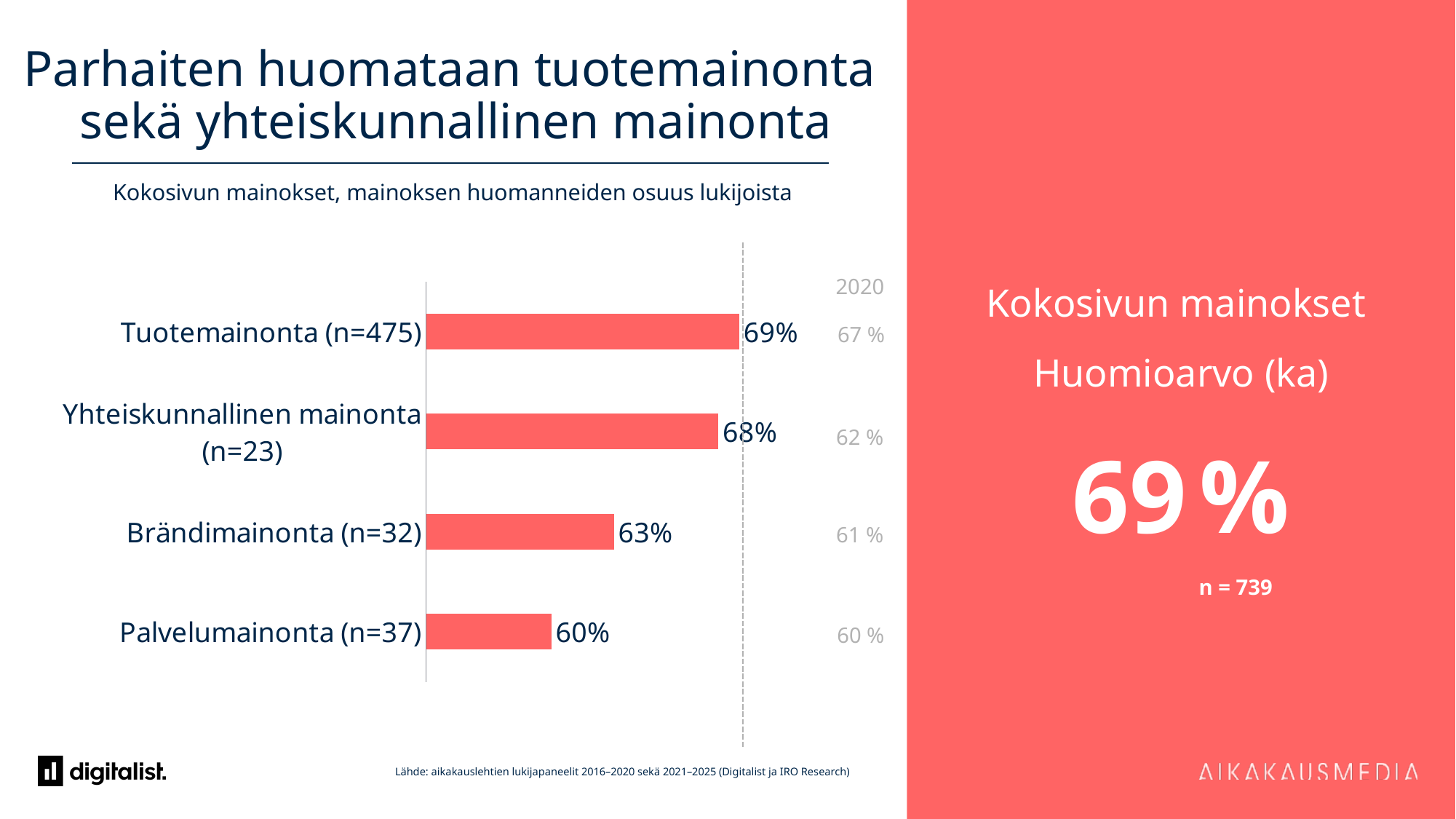
What is the value for Yhteiskunnallinen mainonta (n=23)? 68% Which is larger, the value for Brändimainonta (n=32) or Palvelumainonta (n=37)? Brändimainonta (n=32) What kind of chart is shown on the slide? Bar chart Which category has the lowest value? Palvelumainonta (n=37) What is the value for Brändimainonta (n=32)? 63% What is the difference between the values for Yhteiskunnallinen mainonta (n=23) and Brändimainonta (n=32)? 5% What is the difference between the values for Tuotemainonta (n=475) and Palvelumainonta (n=37)? 9% What is the value for Palvelumainonta (n=37)? 60% What is the value for Tuotemainonta (n=475)? 69% Which category has the highest value? Tuotemainonta (n=475) How many categories are shown in the bar chart? 4 What 2020 value is shown next to Brändimainonta (n=32)? 61 %